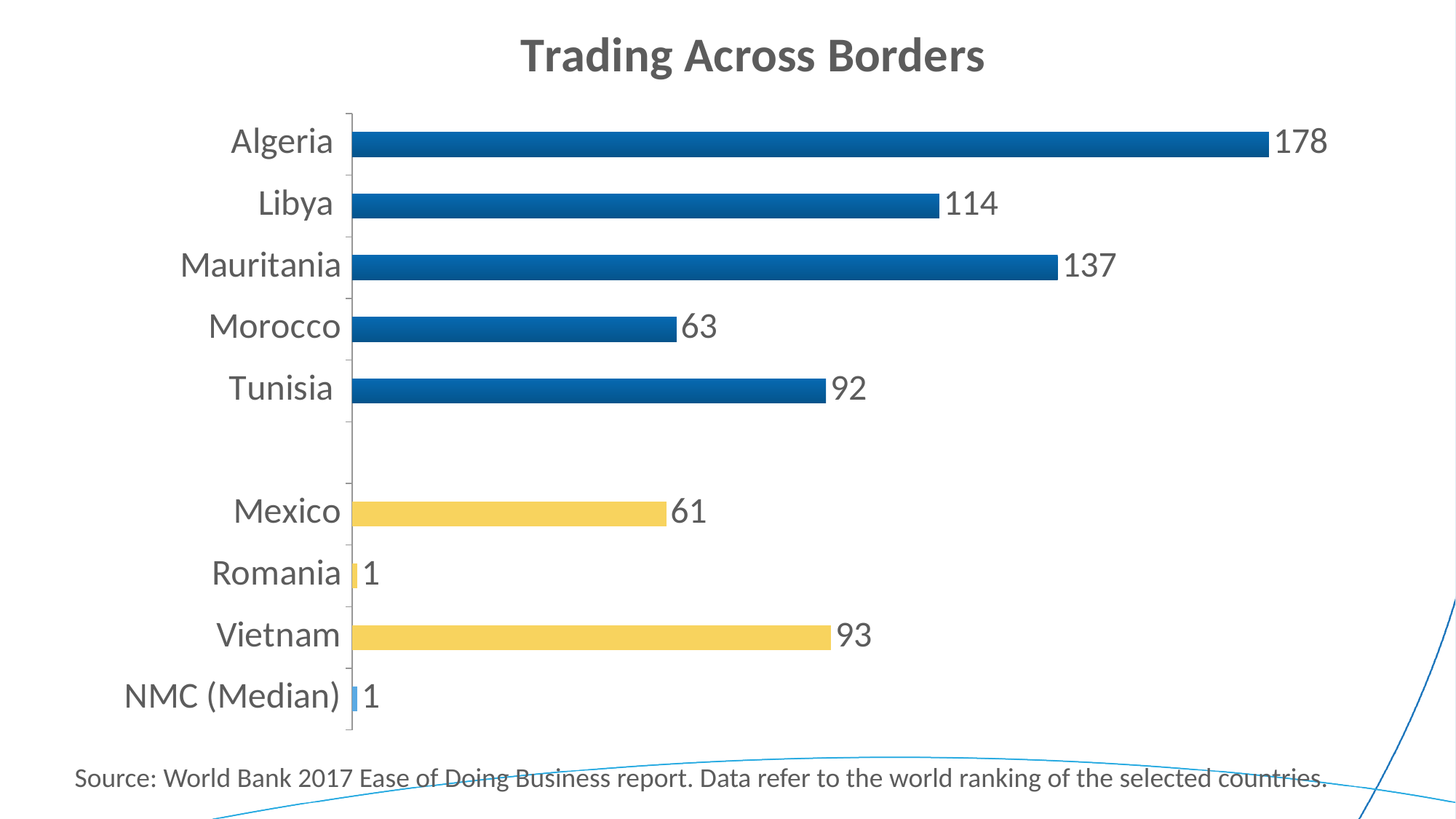
What is the value for Vietnam? 93 How many labelled bars does the chart show? 9 What is the value for Mexico? 61 What is the value for Mauritania? 137 Which has the larger value, Libya or Mauritania? Mauritania What is the difference between the values for Mauritania and Morocco? 74 Which category has the highest value? Algeria What is the value for Algeria? 178 Which has the larger value, Tunisia or Morocco? Tunisia What is the value for NMC (Median)? 1 What type of chart is shown on the slide? Bar chart What is the difference between the values for Algeria and Libya? 64